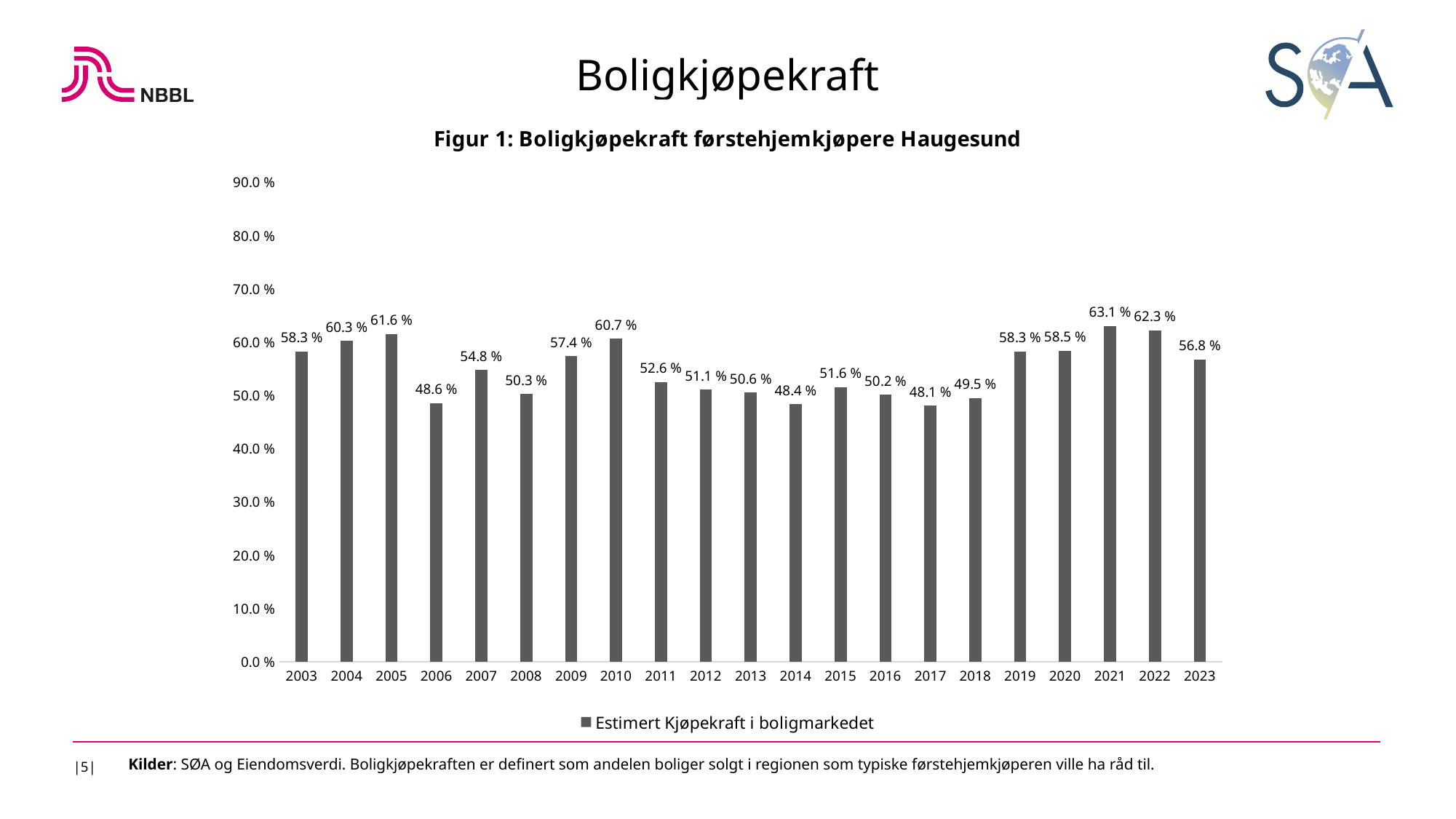
What is the difference between the values for 2021 and 2023? 6.3 % What kind of chart is shown? bar chart Which year has the highest value? 2021 Is the value for 2014 greater or less than 50.0 %? less What is the value for 2023? 56.8 % How many years are shown on the x axis? 21 Which is larger, the value for 2005 or the value for 2009? 2005 How many series does the legend list? 1 Which year has the lowest value? 2017 What is the value for 2006? 48.6 % What is the value for 2010? 60.7 % What is the title of the chart? Figur 1: Boligkjøpekraft førstehjemkjøpere Haugesund